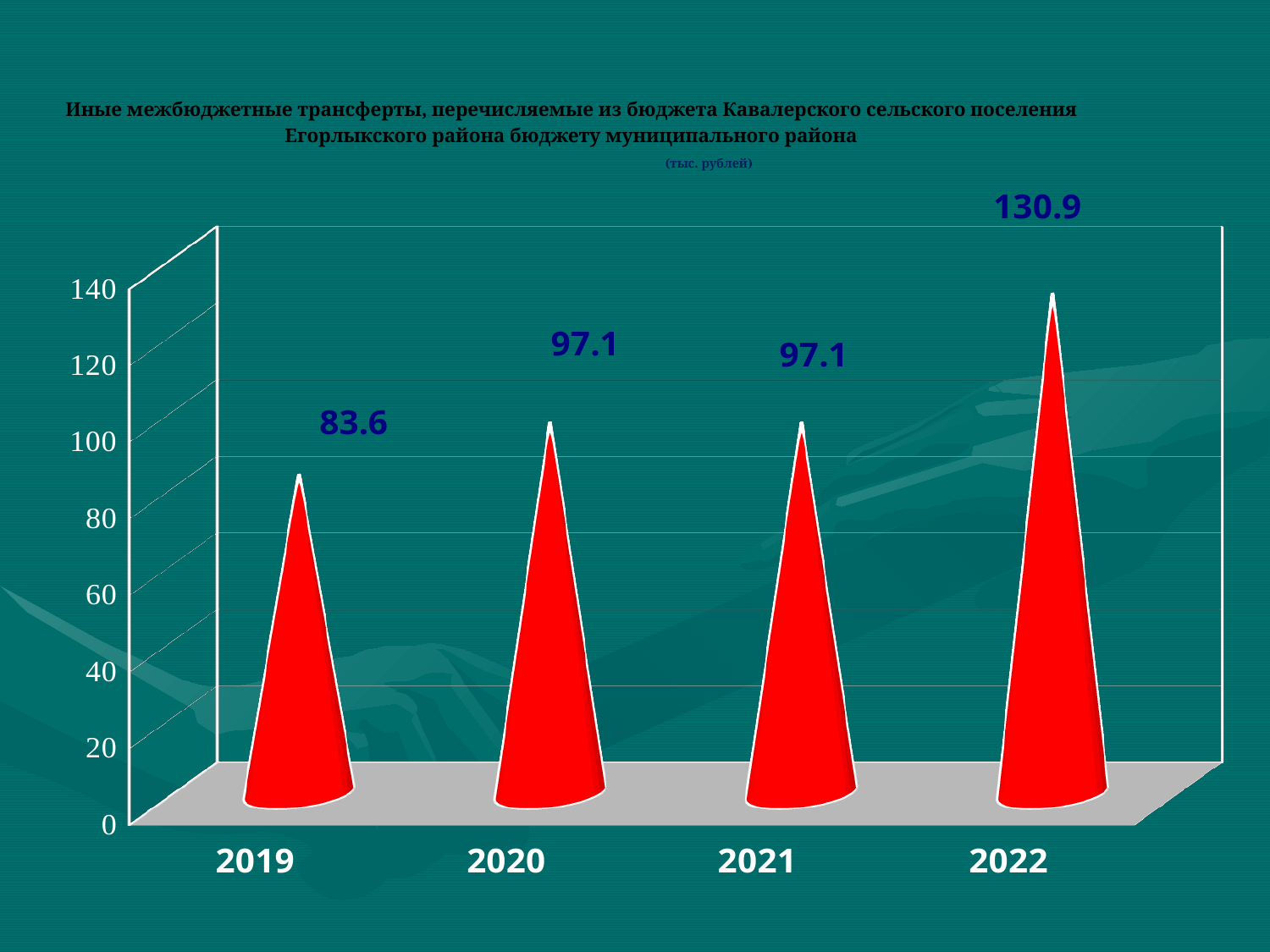
What kind of chart is shown on the slide? bar chart Which is larger, the value for 2021 or the value for 2022? 2022 What is the difference between the values for 2022 and 2019? 47.3 What is the difference between the values for 2020 and 2019? 13.5 What is the value for 2019? 83.6 What is the value for 2022? 130.9 How many years are shown on the x axis? 4 Which year has the highest value? 2022 Which year has the lowest value? 2019 What is the value for 2020? 97.1 What unit is given in the chart title? тыс. рублей Is the value for 2022 greater or less than 120? greater